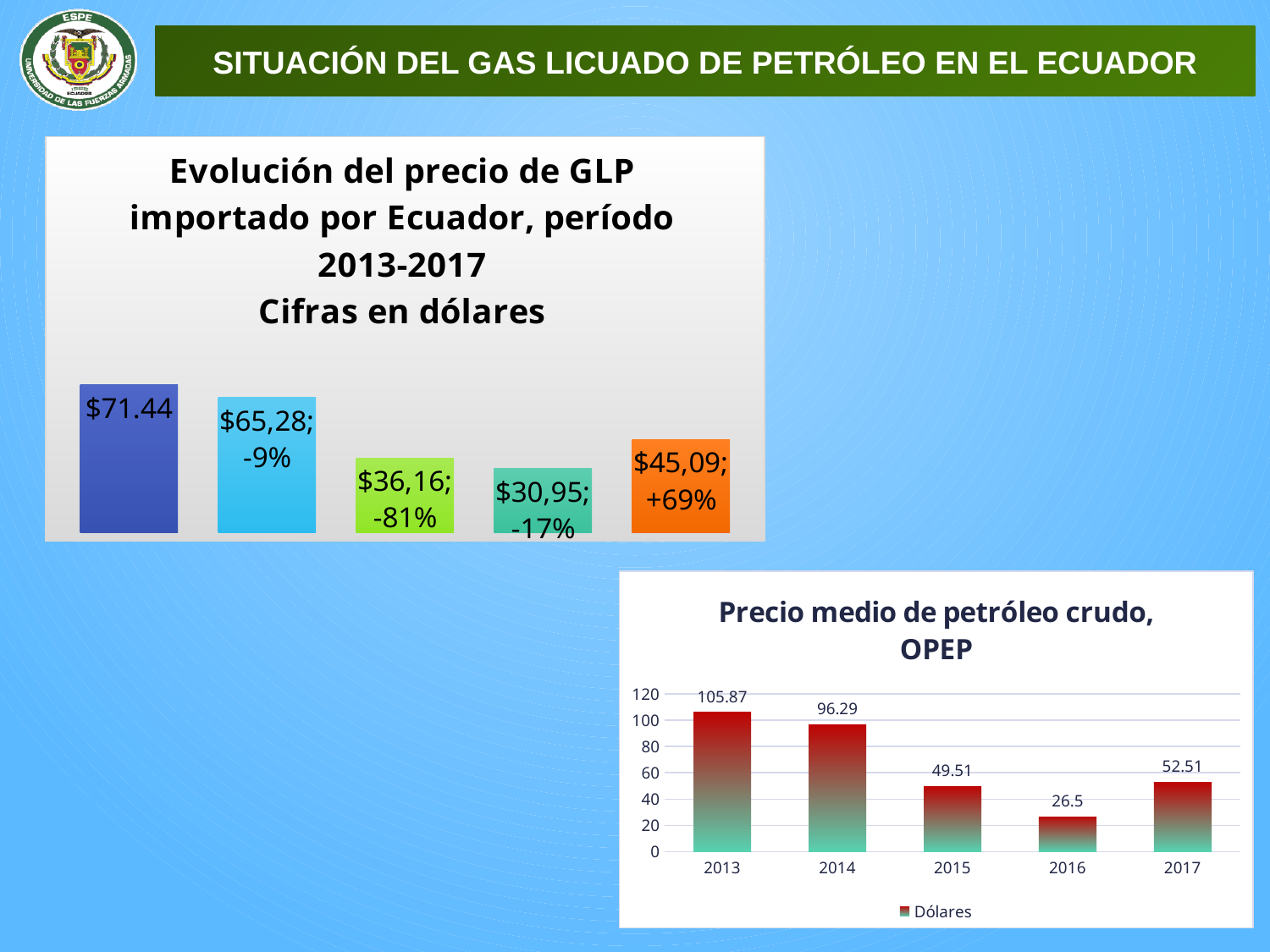
In the chart 'Precio medio de petróleo crudo, OPEP', what is the value for 2016? 26.5 In the chart 'Precio medio de petróleo crudo, OPEP', what is the difference between the 2013 and 2014 values? 9.58 In the chart 'Precio medio de petróleo crudo, OPEP', what is the legend entry? Dólares In the chart 'Evolución del precio de GLP importado por Ecuador', what percentage change is shown on the last (rightmost) bar? +69% In the chart 'Precio medio de petróleo crudo, OPEP', which year has the highest value? 2013 In the chart 'Precio medio de petróleo crudo, OPEP', how many series does the legend list? 1 In the chart 'Precio medio de petróleo crudo, OPEP', which year has the lowest value? 2016 In the chart 'Evolución del precio de GLP importado por Ecuador', what is the value shown on the first (leftmost) bar? $71.44 In the chart 'Precio medio de petróleo crudo, OPEP', how many years are shown on the x axis? 5 In the chart 'Precio medio de petróleo crudo, OPEP', is the value for 2015 larger or smaller than the value for 2017? smaller In the chart 'Precio medio de petróleo crudo, OPEP', what is the value for 2013? 105.87 What kind of chart is 'Evolución del precio de GLP importado por Ecuador'? bar chart